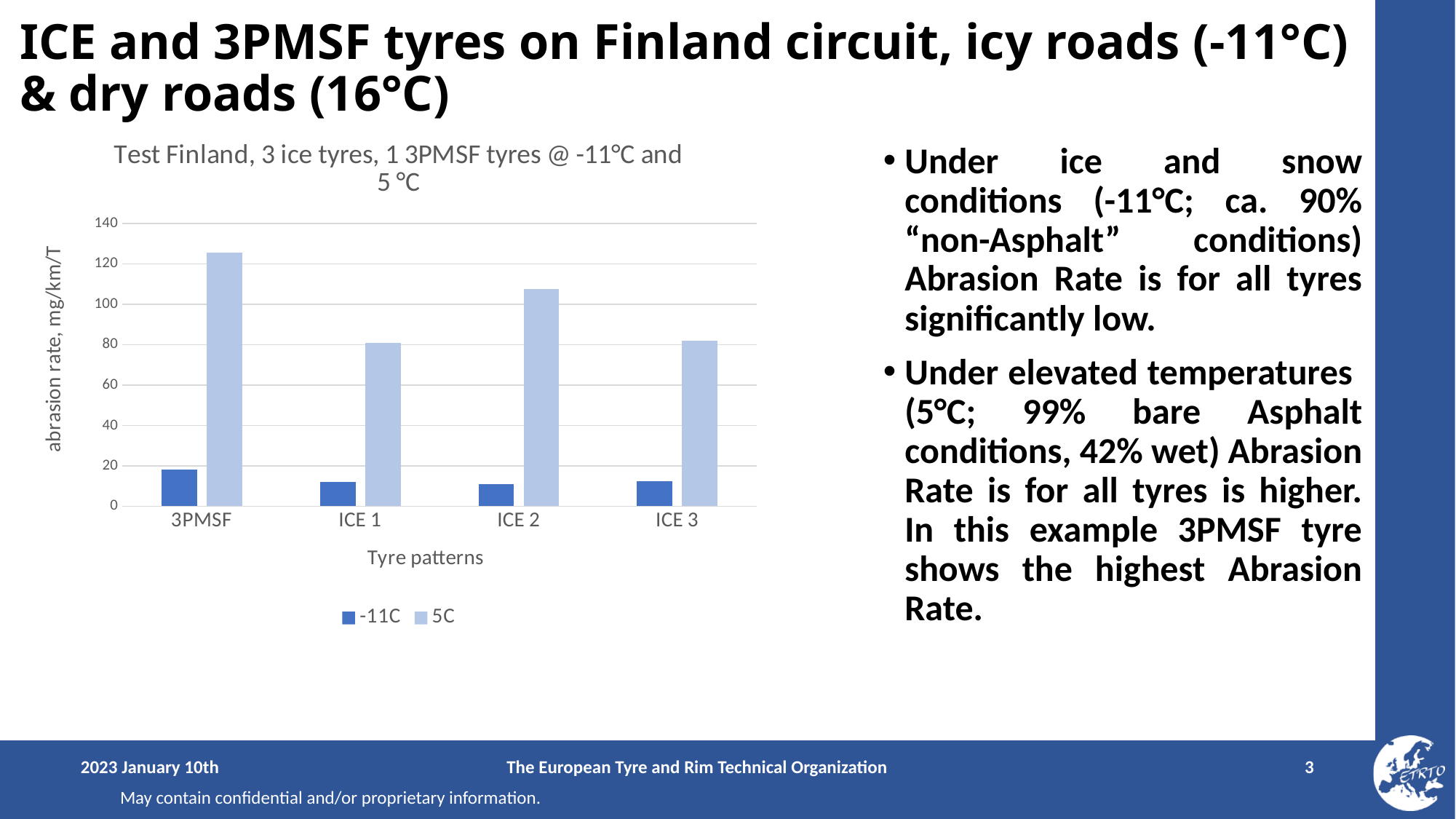
Which tyre pattern has the highest abrasion rate in the 5C series? 3PMSF For ICE 1, which series has the larger value: -11C or 5C? 5C How many series does the chart legend list? 2 Which is larger in the 5C series: ICE 2 or ICE 3? ICE 2 Is the 5C value for 3PMSF greater or less than 120? greater Which tyre pattern has the highest abrasion rate in the -11C series? 3PMSF Is the 5C value for ICE 2 greater or less than 100? greater Is the 5C value for ICE 3 greater or less than 100? less How many tyre patterns are shown on the x axis of the chart? 4 What is the label of the y axis of the chart? abrasion rate, mg/km/T What kind of chart is shown on the slide? bar chart